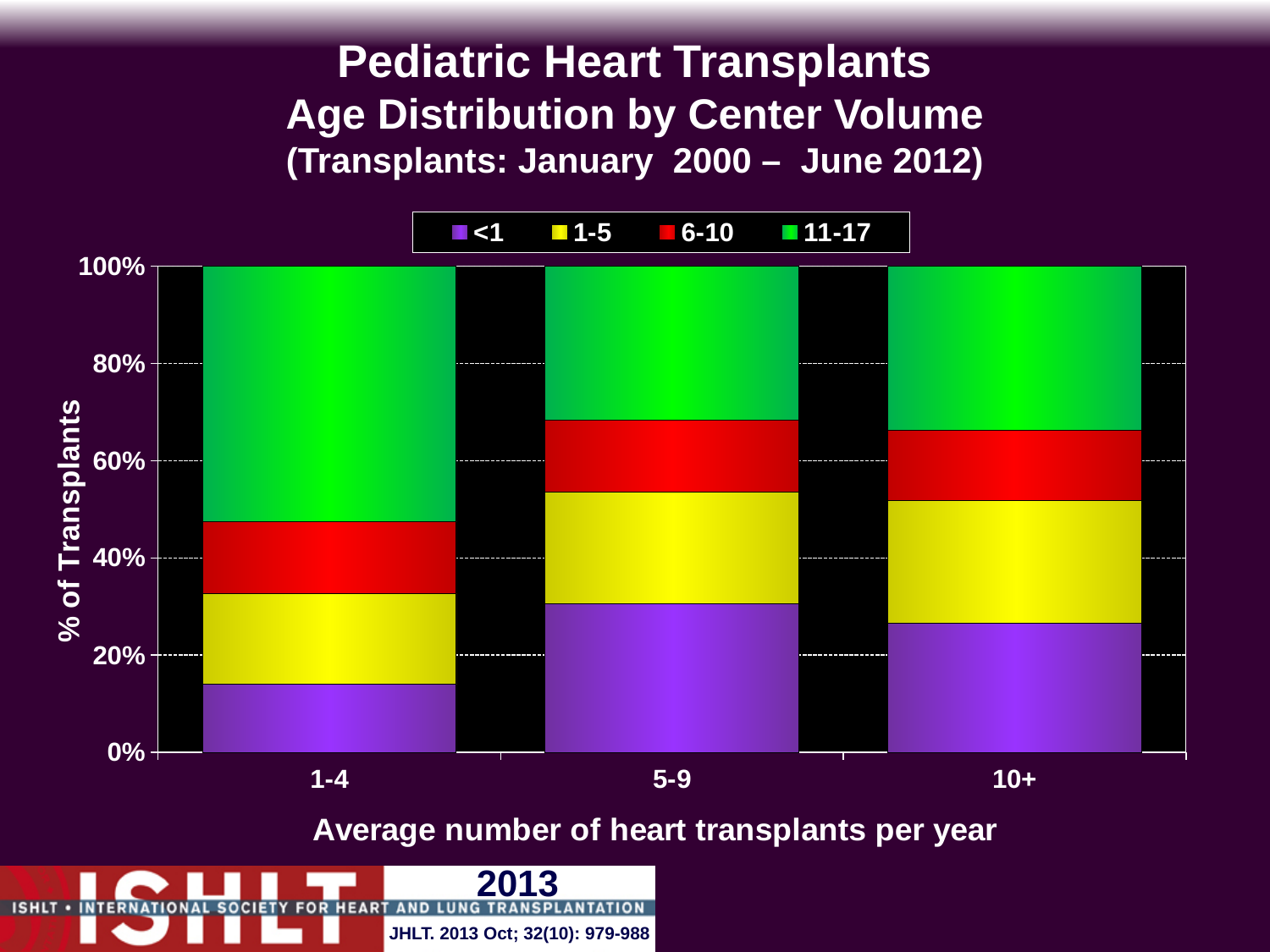
What is the total height of each stacked bar? 100% Which center volume category has the smallest share of transplants in recipients aged <1? 1-4 Is the share of transplants in recipients aged 11-17 larger for centers with 1-4 or 5-9 transplants per year? 1-4 Is the share of transplants in recipients aged 11-17 for centers with 1-4 transplants per year greater or less than 40%? greater Is the share of transplants in recipients aged <1 for centers with 1-4 transplants per year greater or less than 20%? less How many age groups does the legend list? 4 What kind of chart is shown on the slide? Stacked bar chart What is the label of the x axis? Average number of heart transplants per year How many center volume categories are shown on the x axis? 3 Which center volume category has the largest share of transplants in recipients aged <1? 5-9 Is the share of transplants in recipients aged <1 for centers with 5-9 transplants per year greater or less than 20%? greater Which colour represents the 6-10 age group in the legend? Red